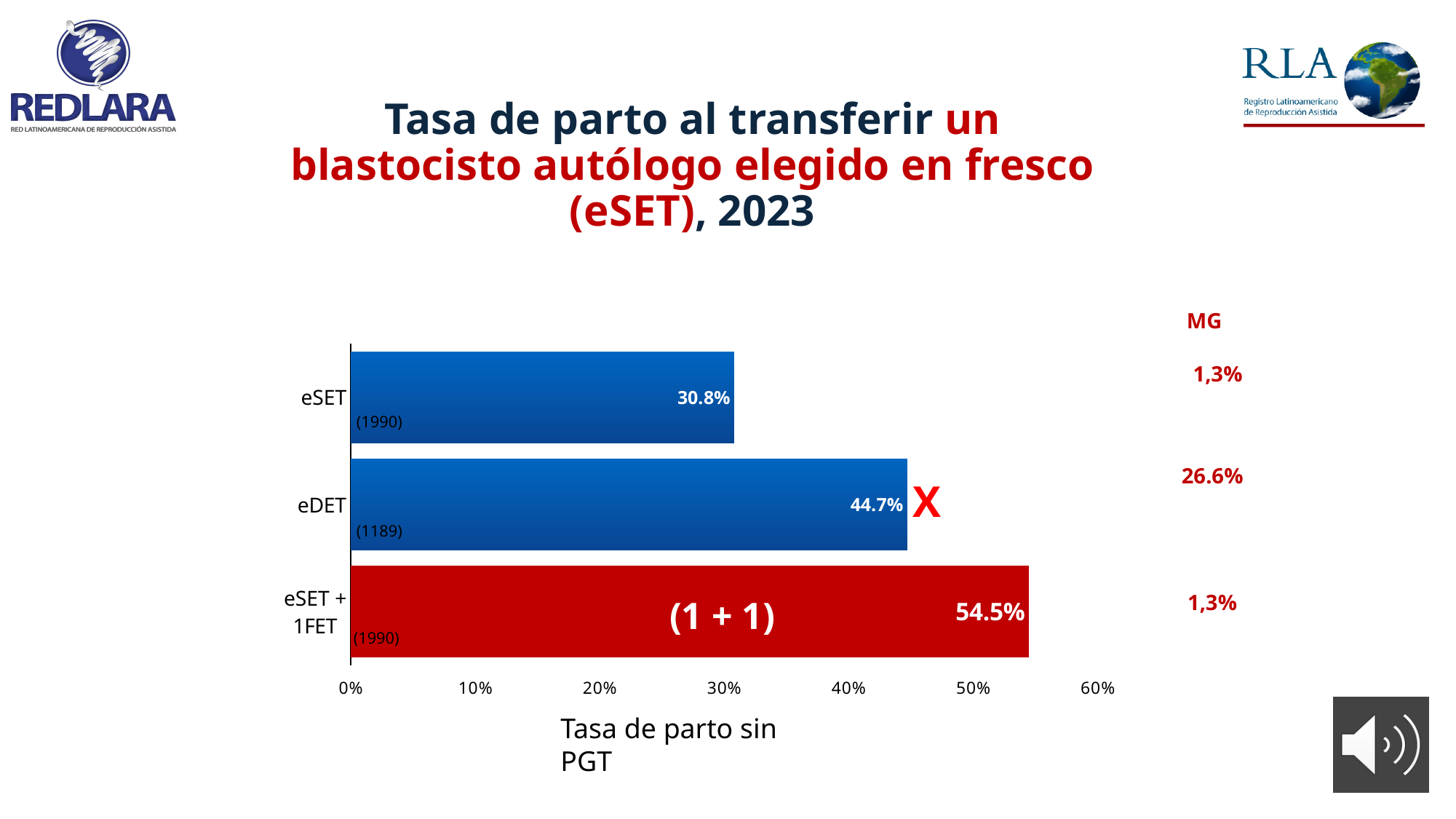
Which category has the highest delivery rate? eSET + 1FET How many categories are shown in the bar chart? 3 Which category has the lowest delivery rate? eSET What is the difference in delivery rate between eDET and eSET? 13.9% What is the delivery rate (tasa de parto) shown for eSET? 30.8% Which has a higher delivery rate, eDET or eSET + 1FET? eSET + 1FET What type of chart is shown on the slide? Bar chart What is the delivery rate shown for eDET? 44.7% What is the MG value shown next to the eDET bar? 26.6% What is the delivery rate shown for eSET + 1FET? 54.5% What is the difference in delivery rate between eSET + 1FET and eSET? 23.7% Is the delivery rate for eDET greater or less than 40%? greater